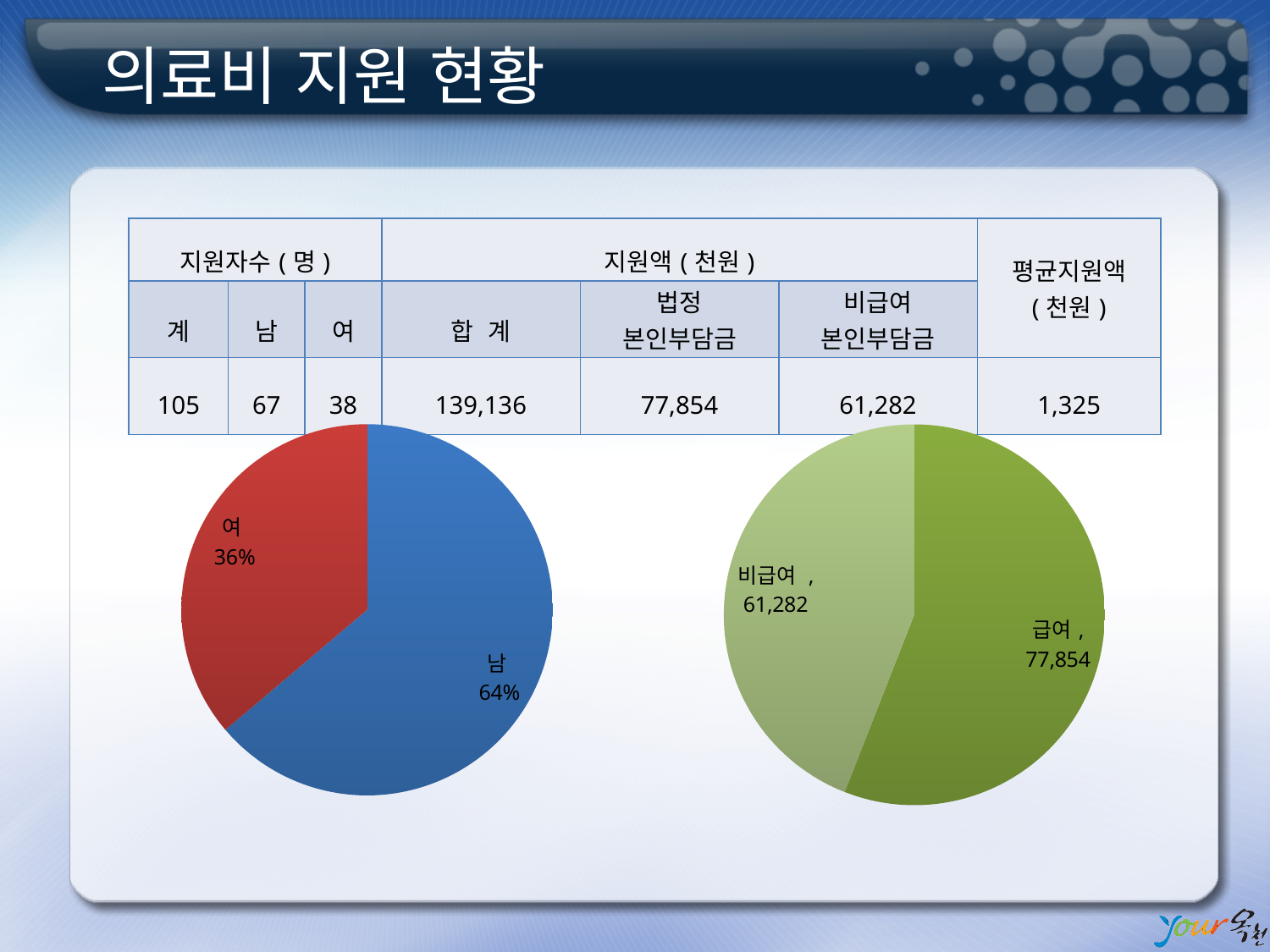
In the left pie chart, what is the difference in percentage points between 남 and 여? 28 In the right pie chart, what is the value for 급여? 77,854 In the right pie chart, what is the difference between 급여 and 비급여? 16,572 How many slices does the right pie chart have? 2 In the left pie chart, what share does 여 have? 36% In the right pie chart, which is larger, 급여 or 비급여? 급여 What kind of chart is the right chart on the slide? pie chart In the right pie chart, what is the value for 비급여? 61,282 In the left pie chart, which slice is the smallest? 여 In the left pie chart, what share does 남 have? 64% What kind of chart is the left chart on the slide? pie chart In the left pie chart, which slice is the largest? 남